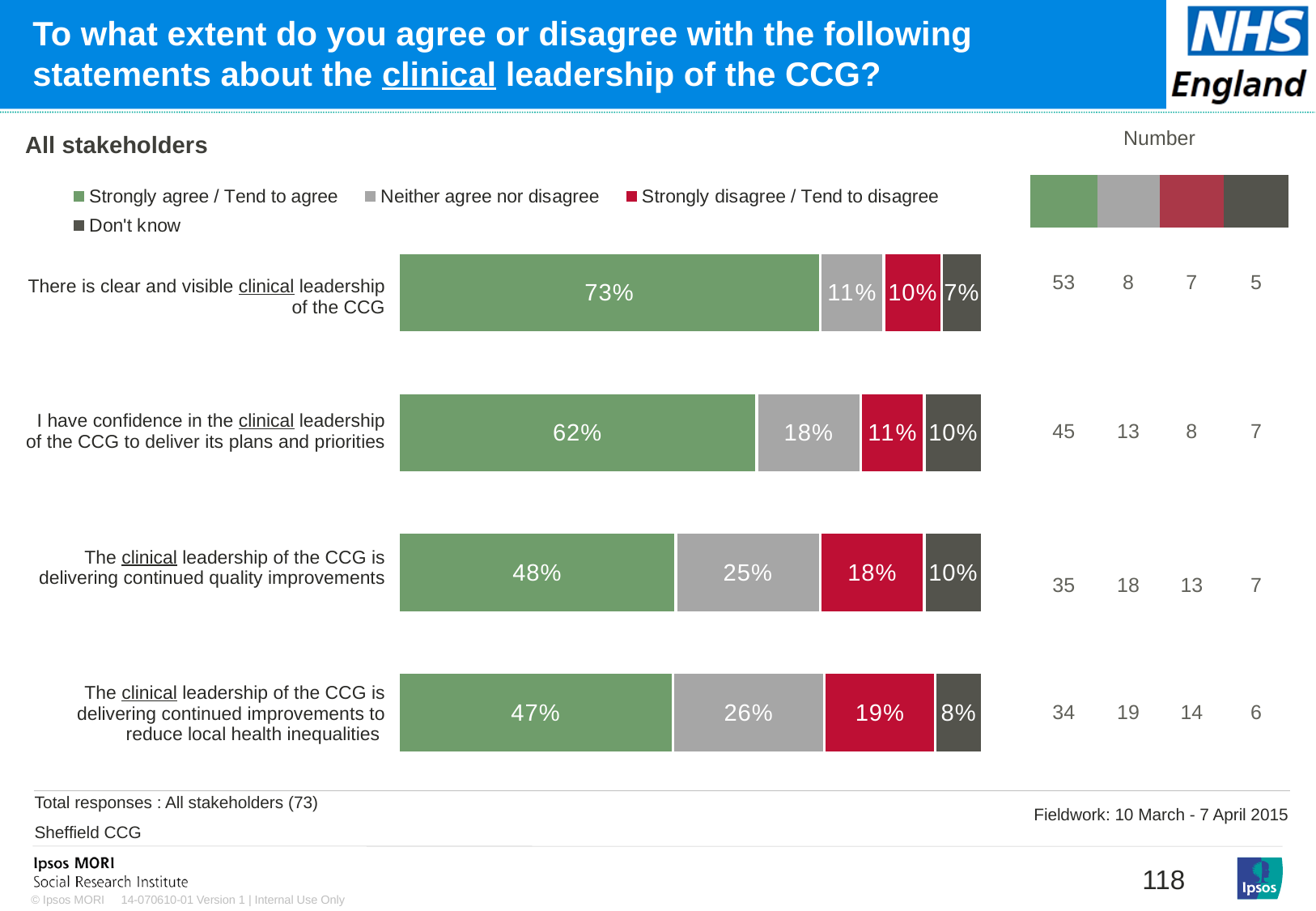
In the 'Number' column, how many stakeholders strongly agree or tend to agree that there is clear and visible clinical leadership of the CCG? 53 How many statements are shown in the chart? 4 What is the difference in the 'Strongly agree / Tend to agree' percentage between the statement about clear and visible clinical leadership and the statement about confidence in the clinical leadership to deliver its plans and priorities? 11 percentage points What percentage neither agree nor disagree that they have confidence in the clinical leadership of the CCG to deliver its plans and priorities? 18% What percentage strongly disagree or tend to disagree that the clinical leadership of the CCG is delivering continued improvements to reduce local health inequalities? 19% What percentage answered 'Don't know' for the statement that the clinical leadership of the CCG is delivering continued quality improvements? 10% Which statement has a larger 'Strongly disagree / Tend to disagree' share: the one about delivering continued quality improvements or the one about confidence in the clinical leadership to deliver its plans and priorities? The clinical leadership of the CCG is delivering continued quality improvements Which statement has the highest percentage of 'Strongly agree / Tend to agree'? There is clear and visible clinical leadership of the CCG How many response categories does the legend list? 4 What percentage of all stakeholders strongly agree or tend to agree that there is clear and visible clinical leadership of the CCG? 73% Which statement has the lowest percentage of 'Strongly agree / Tend to agree'? The clinical leadership of the CCG is delivering continued improvements to reduce local health inequalities What type of chart is used on this slide? Stacked bar chart